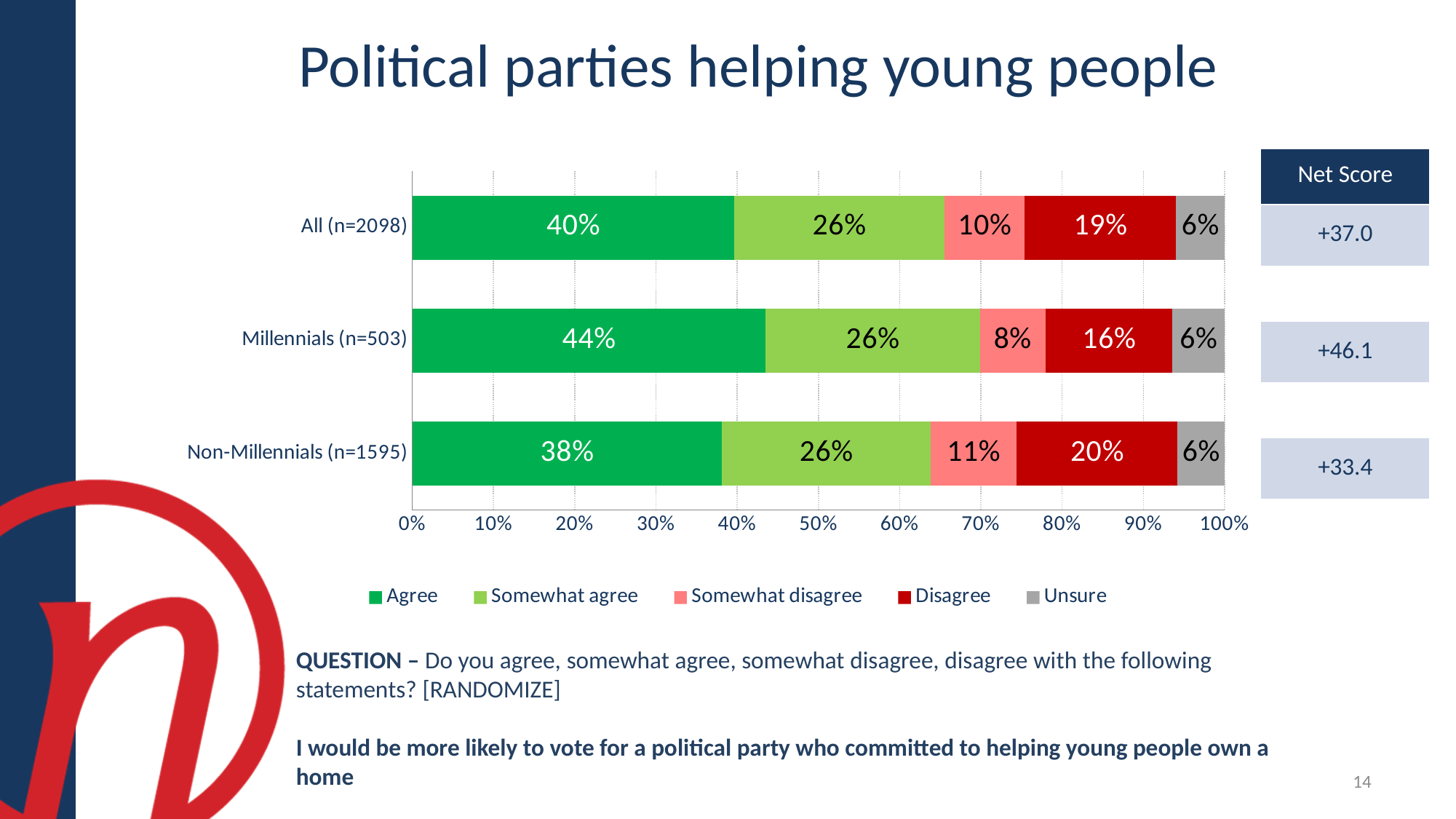
Which group has the highest Agree percentage? Millennials (n=503) What percentage of Non-Millennials (n=1595) disagree? 20% Which group has the lowest Agree percentage? Non-Millennials (n=1595) How many groups are shown on the chart? 3 What is the difference between the Agree percentage for Millennials (n=503) and Non-Millennials (n=1595)? 6% What percentage of All (n=2098) somewhat disagree? 10% What percentage of Millennials (n=503) agree? 44% What is the combined percentage of Agree and Somewhat agree for Millennials (n=503)? 70% How many series does the legend list? 5 What is the Net Score shown for Non-Millennials (n=1595)? +33.4 Which is larger: the Disagree percentage for All (n=2098) or for Millennials (n=503)? All (n=2098) What kind of chart is shown on the slide? Stacked bar chart